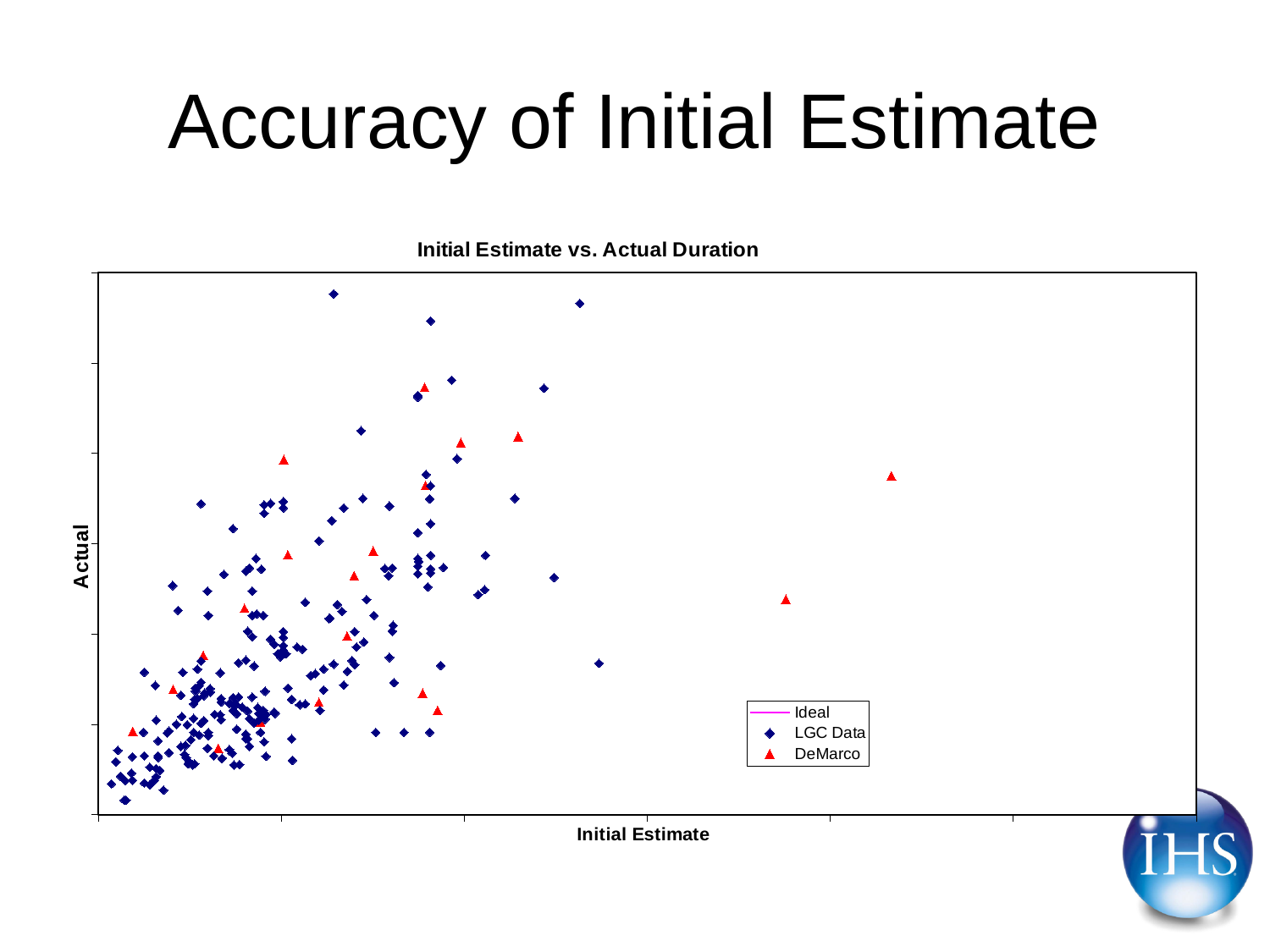
What kind of chart is shown on the slide? scatter chart What is the title of the chart? Initial Estimate vs. Actual Duration Which series in the chart is plotted with red triangles? DeMarco How many series does the legend of the chart list? 3 Do the Actual values generally rise or fall as the Initial Estimate increases along the x axis? rise Which series has more plotted points, LGC Data or DeMarco? LGC Data